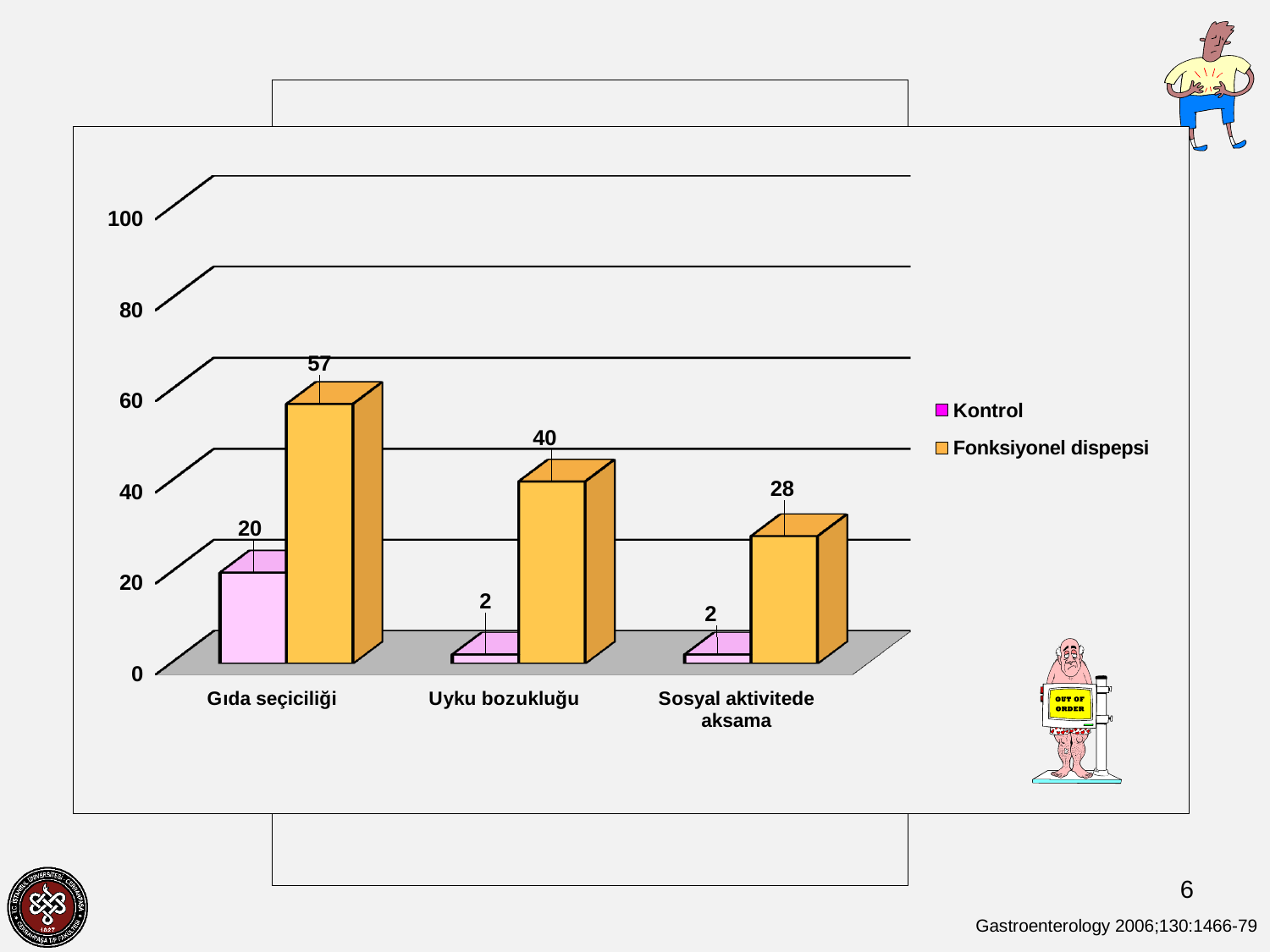
What is the value for Fonksiyonel dispepsi in the Gıda seçiciliği category? 57 What is the value for Kontrol in the Uyku bozukluğu category? 2 What is the difference between the Fonksiyonel dispepsi values for Gıda seçiciliği and Sosyal aktivitede aksama? 29 Which category has the highest Fonksiyonel dispepsi value? Gıda seçiciliği What kind of chart is shown on the slide? Bar chart How many series does the legend list? 2 Which category has the lowest Fonksiyonel dispepsi value? Sosyal aktivitede aksama Which is larger: the Kontrol value for Gıda seçiciliği or the Fonksiyonel dispepsi value for Sosyal aktivitede aksama? Fonksiyonel dispepsi value for Sosyal aktivitede aksama How many categories are shown on the x axis? 3 What is the value for Kontrol in the Gıda seçiciliği category? 20 What is the difference between the Fonksiyonel dispepsi and Kontrol values for Uyku bozukluğu? 38 What is the value for Fonksiyonel dispepsi in the Sosyal aktivitede aksama category? 28